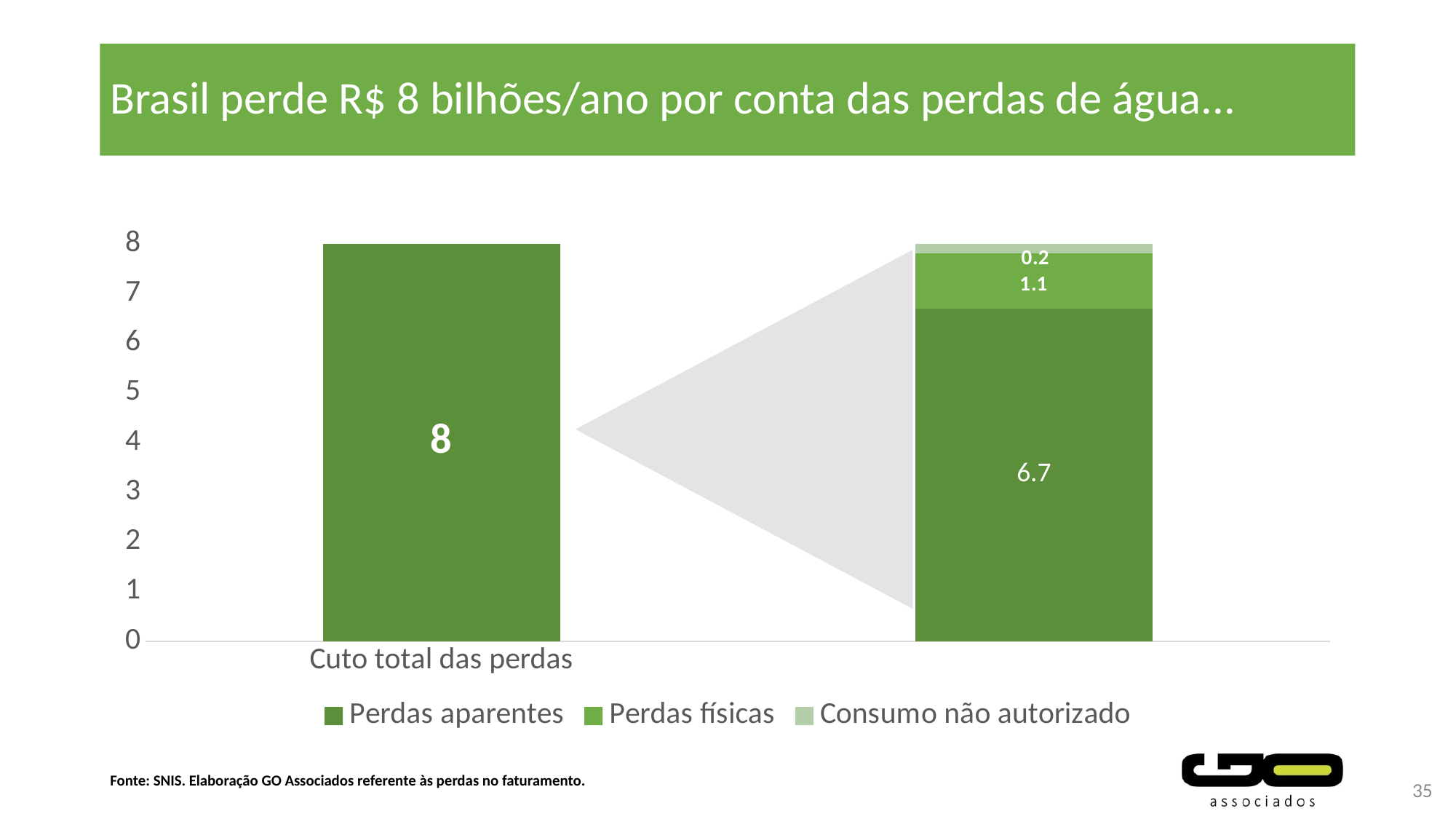
Which series has the smallest segment in the stacked bar on the right? Consumo não autorizado In the stacked bar on the right, what is the value of the "Perdas aparentes" segment? 6.7 What is the difference between the "Perdas aparentes" segment and the "Perdas físicas" segment in the stacked bar? 5.6 Which series has the largest segment in the stacked bar on the right? Perdas aparentes How many series does the legend list? 3 What kind of chart is shown on the slide? Bar chart In the stacked bar on the right, what is the value of the "Perdas físicas" segment? 1.1 In the stacked bar on the right, what is the value of the "Consumo não autorizado" segment? 0.2 What is the total of the stacked bar on the right? 8 What is the value of the bar labelled "Cuto total das perdas"? 8 Is the value of the "Perdas aparentes" segment greater or less than 5? greater Which is larger in the stacked bar: "Perdas físicas" or "Consumo não autorizado"? Perdas físicas